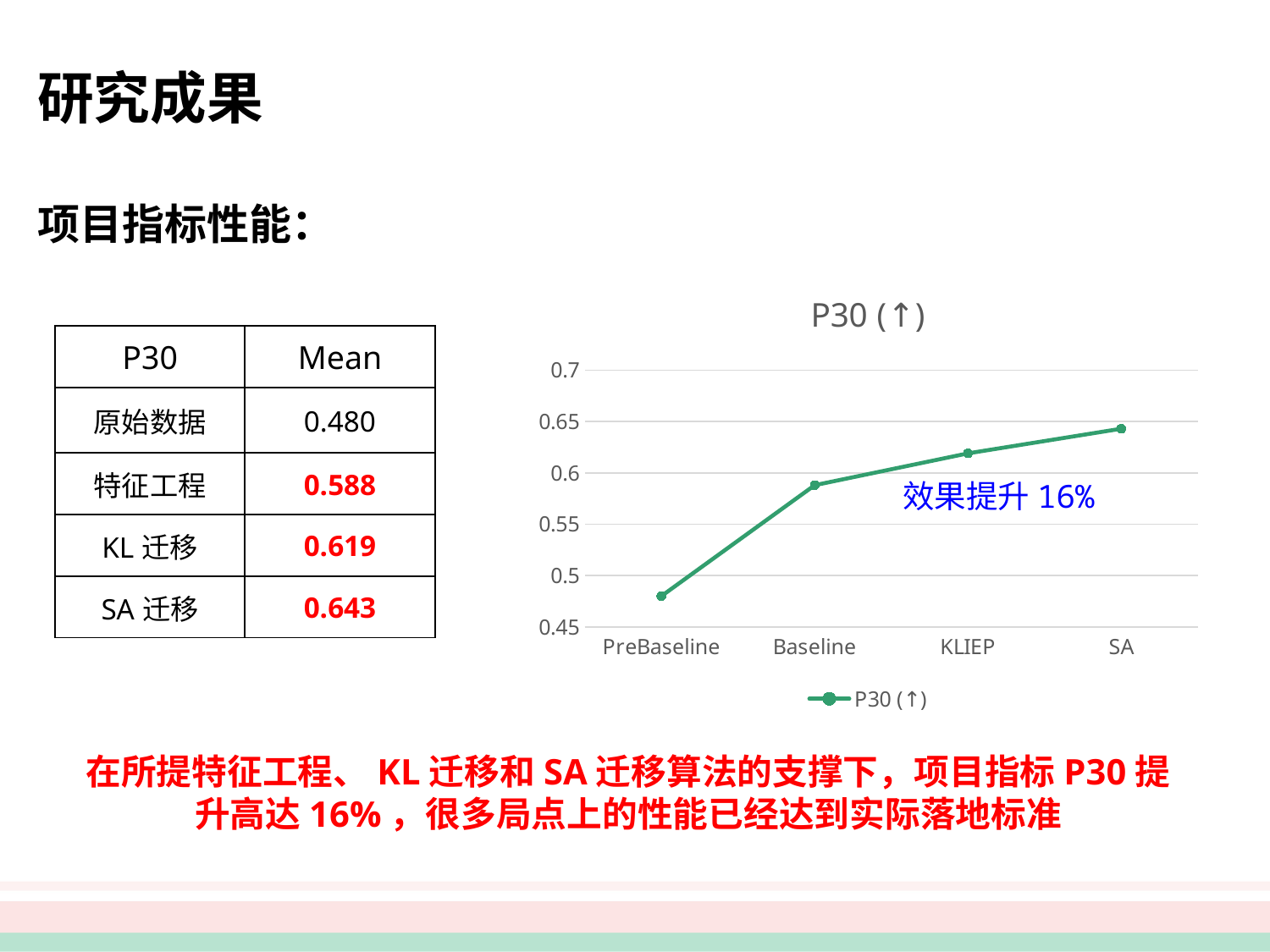
Is the value for KLIEP greater or less than 0.6? greater How many categories are plotted along the x axis of the chart? 4 Is the value for SA greater or less than 0.6? greater Which has a larger P30 value, Baseline or SA? SA Do the P30 values rise or fall from PreBaseline to SA along the x axis? rise Is the value for PreBaseline greater or less than 0.5? less What is the title of the chart? P30 (↑) Which category has the lowest P30 value in the chart? PreBaseline How many series does the chart legend list? 1 What kind of chart is shown on the slide? line chart Which category has the highest P30 value in the chart? SA